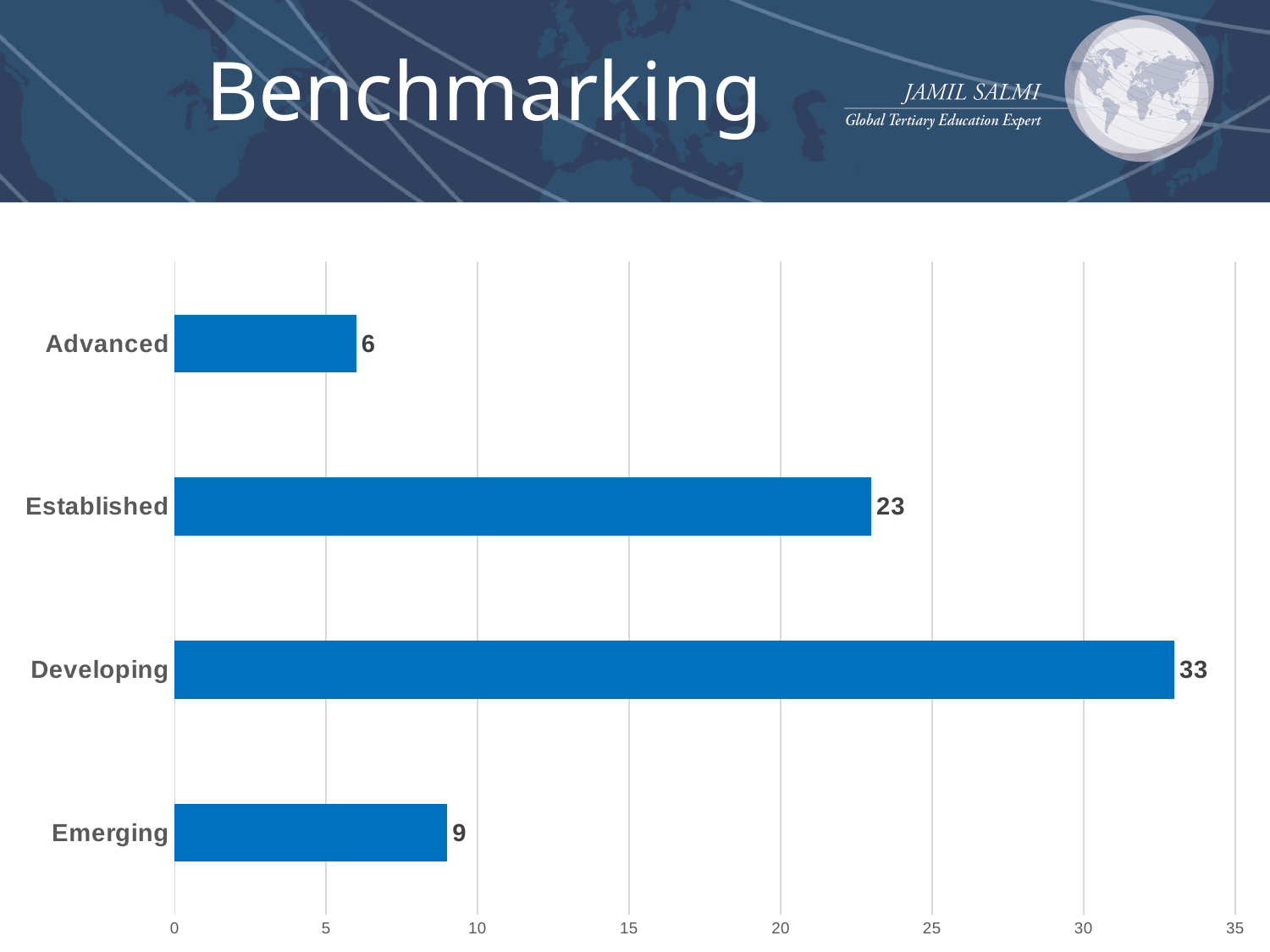
What is the value for Emerging? 9 How many categories are shown in the chart? 4 What is the value for Developing? 33 Which category has the lowest value? Advanced What kind of chart is shown on the slide? Bar chart What is the value for Established? 23 What is the difference between the values for Developing and Established? 10 What is the difference between the values for Emerging and Advanced? 3 Which is larger, the value for Established or the value for Emerging? Established What is the value for Advanced? 6 Is the value for Established greater or less than 20? greater Which category has the highest value? Developing